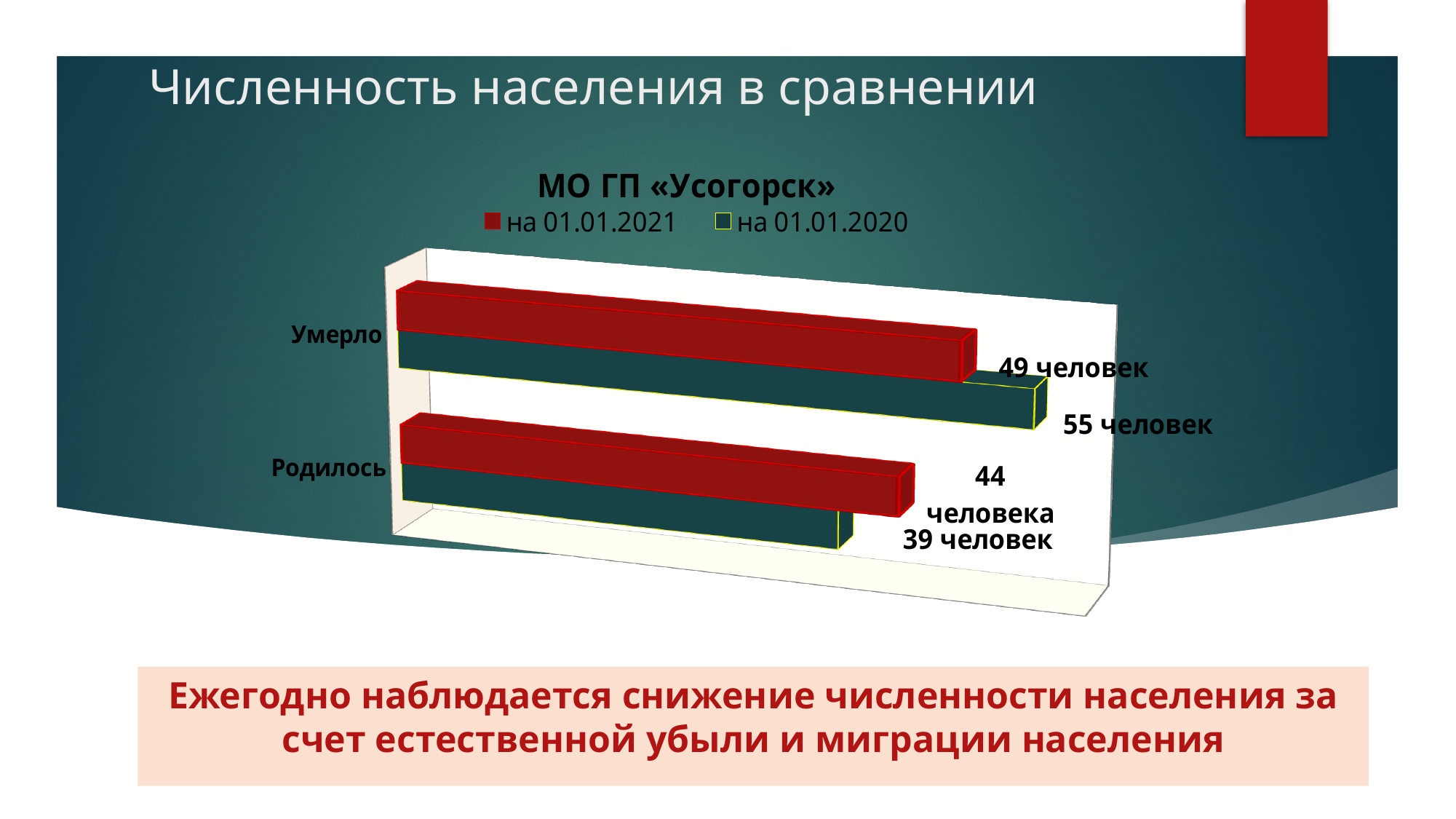
What is the value for Родилось in the series на 01.01.2020? 39 человек What is the value for Родилось in the series на 01.01.2021? 44 человека Which is larger for Родилось: the value for на 01.01.2021 or на 01.01.2020? на 01.01.2021 What is the title of the chart? МО ГП «Усогорск» What kind of chart is shown on the slide? bar chart How many series does the chart legend list? 2 Which category has the highest value in the series на 01.01.2020? Умерло What is the value for Умерло in the series на 01.01.2021? 49 человек Which category has the lowest value in the series на 01.01.2021? Родилось How many categories are shown on the chart? 2 What is the value for Умерло in the series на 01.01.2020? 55 человек What is the difference between the Умерло values for на 01.01.2020 and на 01.01.2021? 6